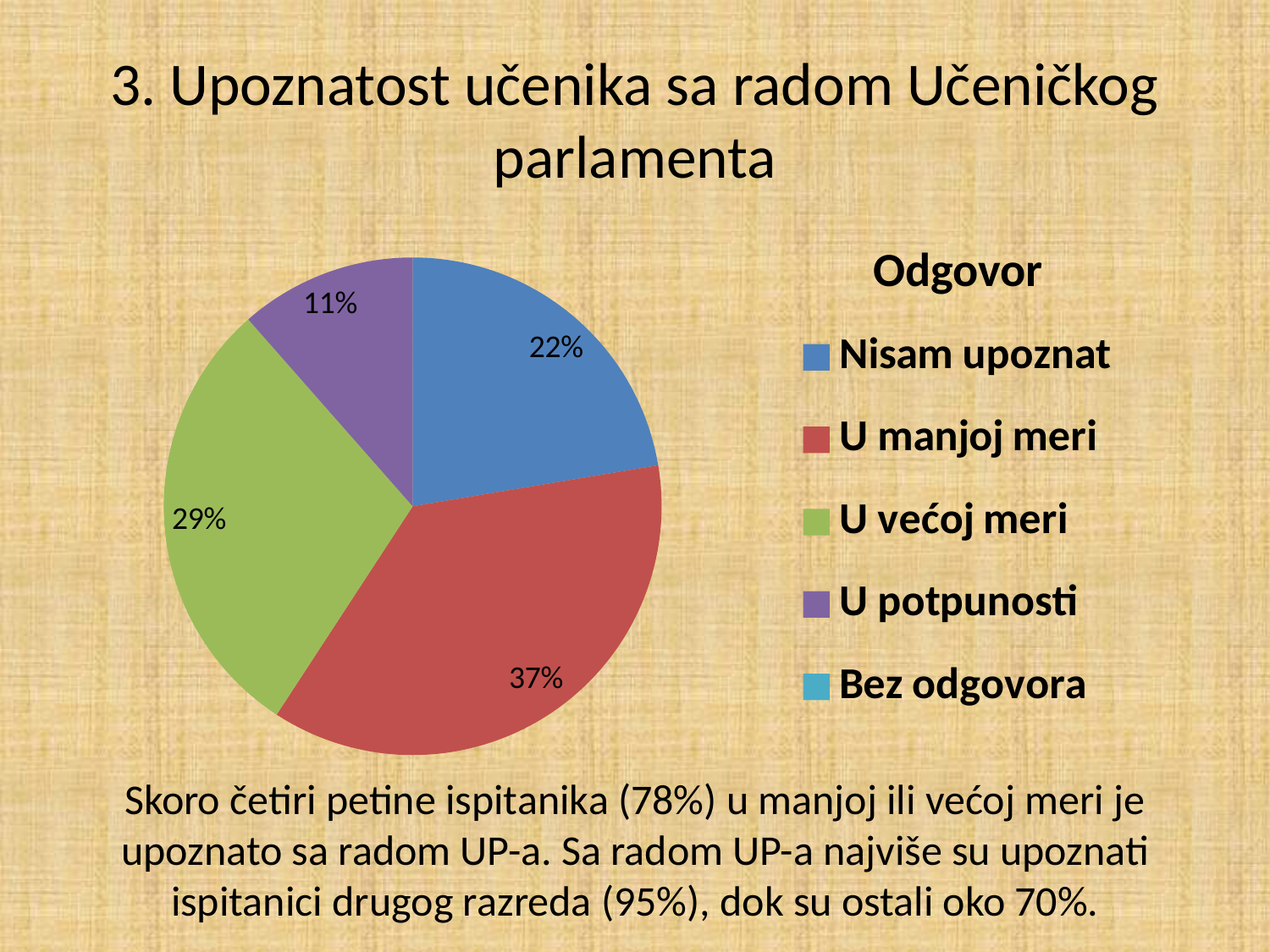
Which is larger, the share for "U većoj meri" or the share for "Nisam upoznat"? U većoj meri What kind of chart is shown on the slide? pie chart What share of the pie does "U manjoj meri" represent? 37% Which labelled slice is the smallest in the pie? U potpunosti How many entries does the legend list? 5 What share of the pie does "Nisam upoznat" represent? 22% Which category has the largest slice of the pie? U manjoj meri What is the title shown above the legend? Odgovor What colour is the slice for "U većoj meri"? green What is the difference in percentage points between "U manjoj meri" and "Nisam upoznat"? 15 What share of the pie does "U potpunosti" represent? 11%